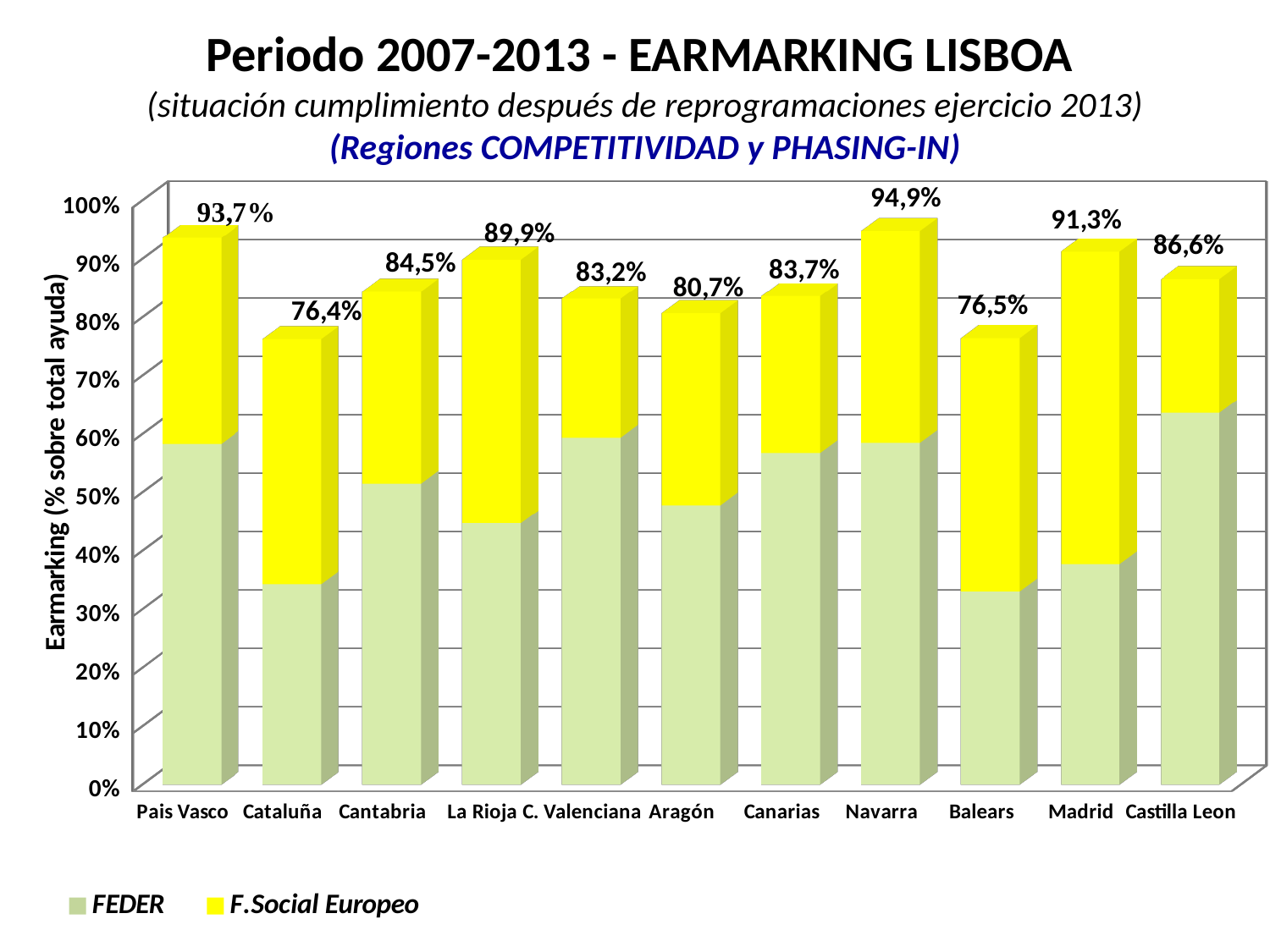
Is the FEDER value for Castilla Leon greater or less than 60%? greater How many regions are shown on the x axis? 11 What is the difference between the total values for Navarra and Pais Vasco? 1,2 percentage points What is the total earmarking value shown for Madrid? 91,3% How many series does the legend list? 2 What kind of chart is shown on the slide? Stacked bar chart Is the FEDER value for Balears greater or less than 40%? less Which region has the highest total earmarking value? Navarra Which has a higher total earmarking value, La Rioja or Cantabria? La Rioja What is the total earmarking value shown for Navarra? 94,9% What is the difference between the total values for Madrid and Cataluña? 14,9 percentage points What is the total earmarking value shown for Cataluña? 76,4%